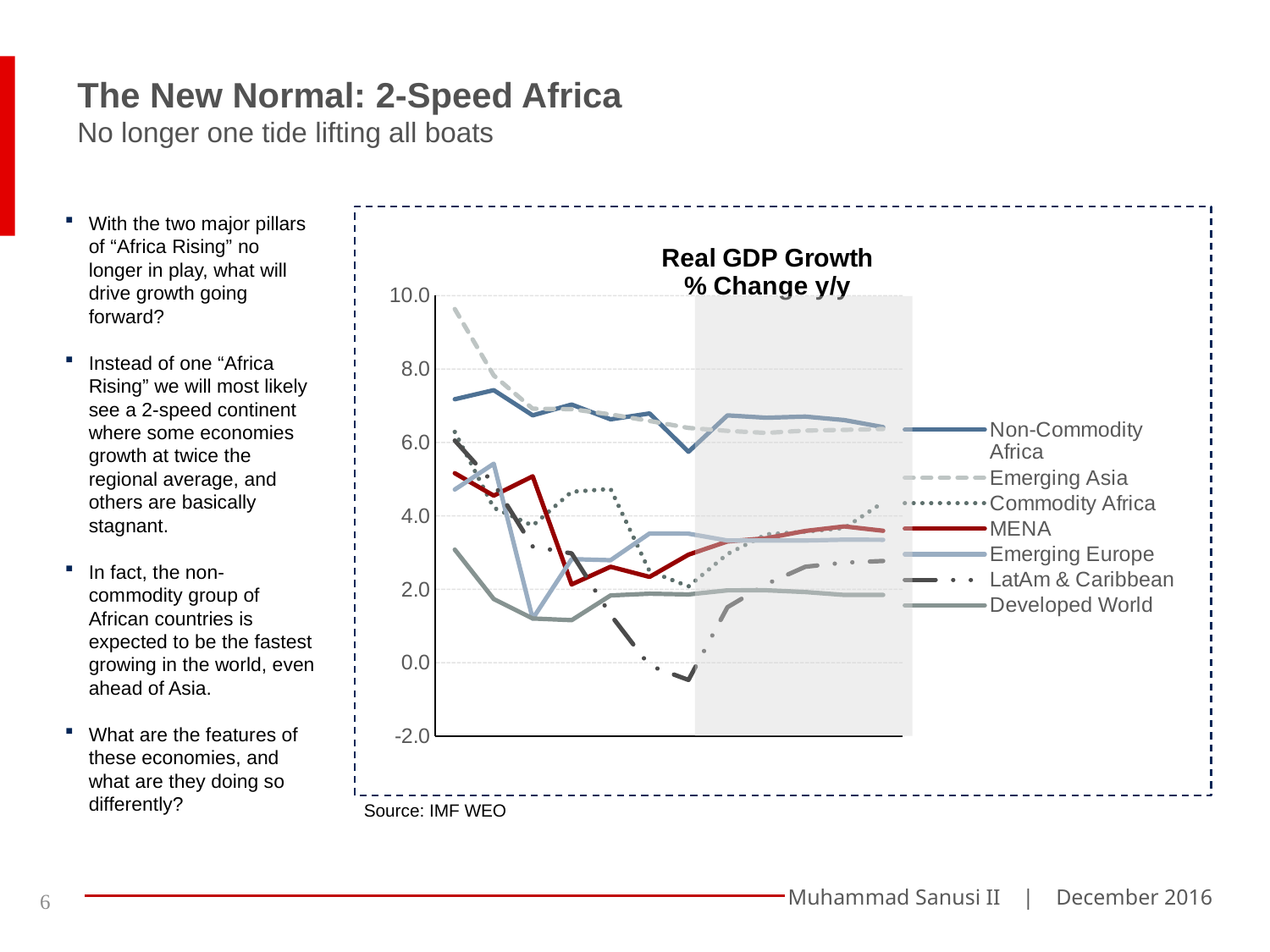
What kind of chart is shown on the slide? line chart Is the last (rightmost) value of Developed World greater or less than 4.0? less Does the Emerging Asia line rise or fall overall from left to right? fall How many series does the chart's legend list? 7 Which series has the highest value at the left edge of the chart? Emerging Asia Which series reaches the lowest value anywhere on the chart? LatAm & Caribbean At the right end of the chart, which is higher: Non-Commodity Africa or Developed World? Non-Commodity Africa Is the lowest point of the LatAm & Caribbean line greater or less than 0.0? less Is the first (leftmost) value of Emerging Asia greater or less than 8.0? greater Which series in the chart is drawn as a solid red line? MENA What is the title of the chart? Real GDP Growth % Change y/y